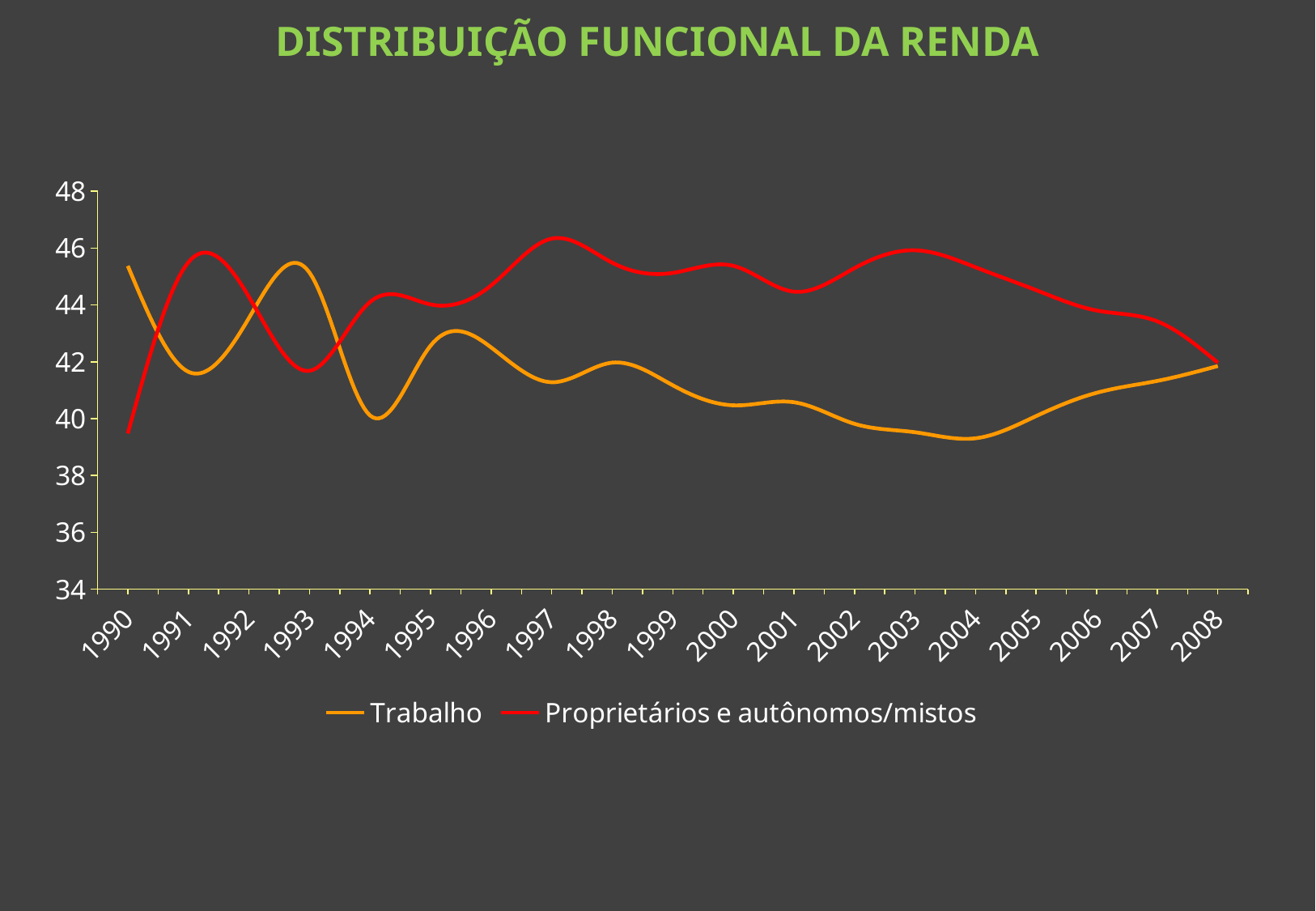
In 1990, which series has the higher value, Trabalho or Proprietários e autônomos/mistos? Trabalho Is the value for Proprietários e autônomos/mistos in 1997 greater or less than 46? greater In which year is the value for Proprietários e autônomos/mistos lowest? 1990 What kind of chart is shown on the slide? line chart Which series is drawn in red? Proprietários e autônomos/mistos Is the value for Trabalho in 1994 greater or less than 42? less How many years are plotted along the x axis? 19 How many series does the legend list? 2 In 1997, which series has the higher value, Trabalho or Proprietários e autônomos/mistos? Proprietários e autônomos/mistos Does the value for Proprietários e autônomos/mistos rise or fall from 2003 to 2008? fall What is the title of the chart? DISTRIBUIÇÃO FUNCIONAL DA RENDA Is the value for Trabalho in 2004 greater or less than 40? less